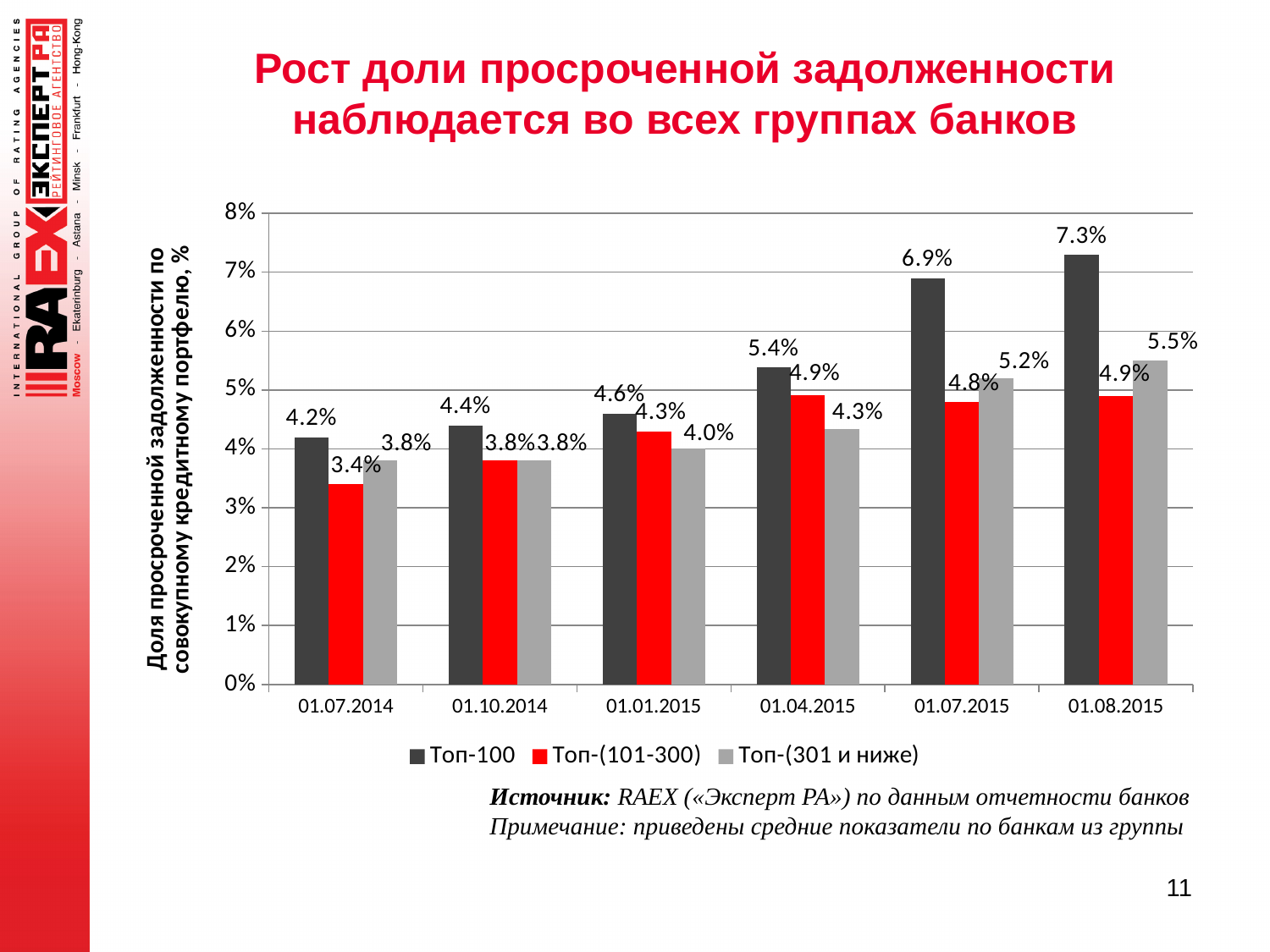
What kind of chart is shown on the slide? Bar chart Which is larger on 01.07.2015: the Топ-(101-300) value or the Топ-(301 и ниже) value? Топ-(301 и ниже) Which colour represents the Топ-(101-300) series? Red On which date is the Топ-(101-300) value lowest? 01.07.2014 What is the value for Топ-100 on 01.08.2015? 7.3% What is the value for Топ-(301 и ниже) on 01.07.2015? 5.2% Do the Топ-100 values rise or fall from 01.07.2014 to 01.08.2015? Rise How many series does the legend list? 3 How many dates are shown on the x axis? 6 What is the value for Топ-(101-300) on 01.07.2014? 3.4% What is the difference between the Топ-100 value and the Топ-(101-300) value on 01.08.2015? 2.4% On which date is the Топ-100 value highest? 01.08.2015